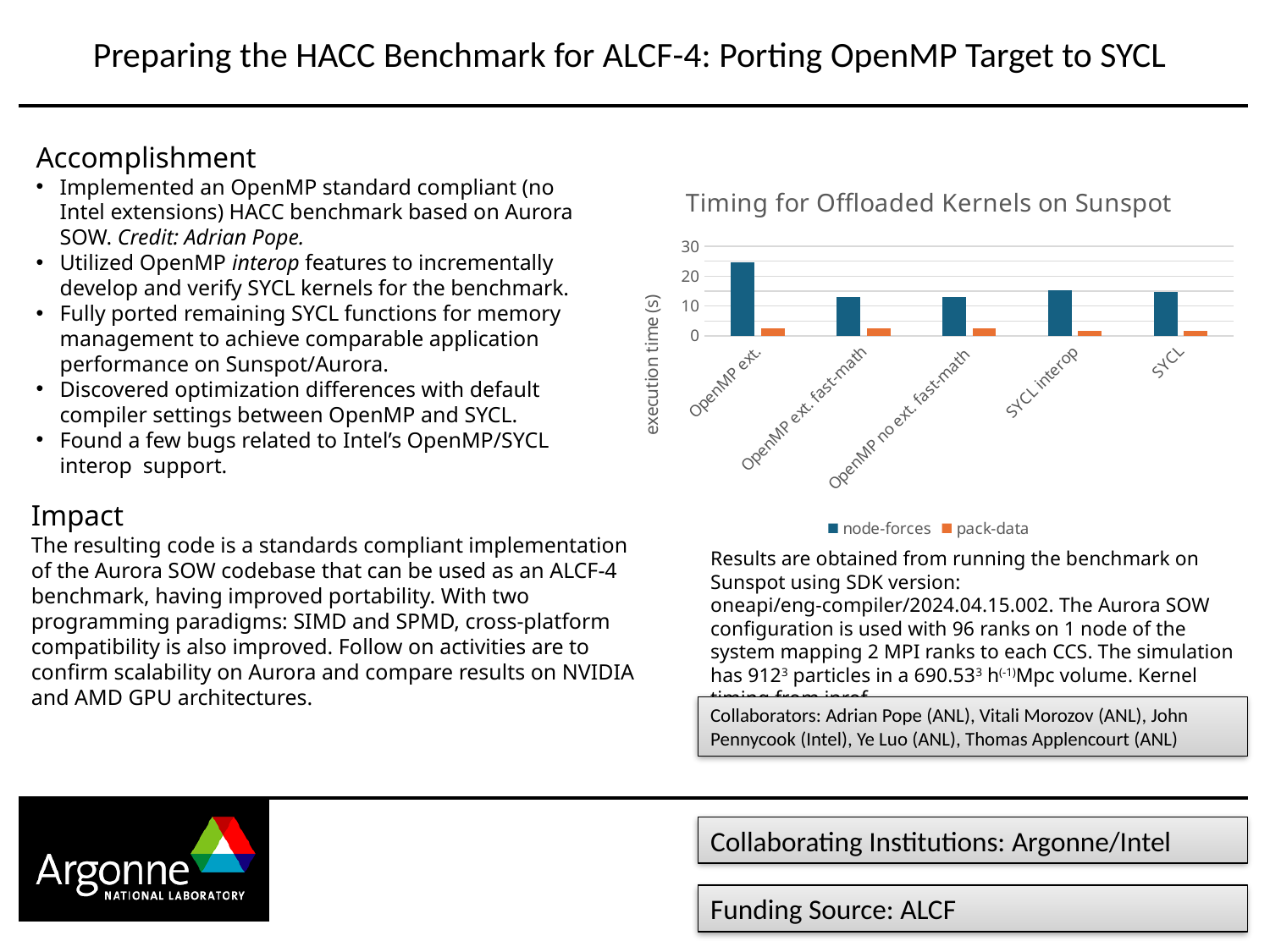
Is the node-forces value for SYCL greater or less than 10? greater What kind of chart is shown on the slide? bar chart For SYCL interop, which series has the larger value, node-forces or pack-data? node-forces What is the title of the chart? Timing for Offloaded Kernels on Sunspot Which category has the highest node-forces execution time? OpenMP ext. What is the label of the y axis of the chart? execution time (s) How many series does the chart legend list? 2 Which is larger: the node-forces value for OpenMP ext. or the node-forces value for SYCL? OpenMP ext. Is the node-forces value for SYCL interop greater or less than 20? less How many categories are shown on the x axis of the chart? 5 Is the node-forces value for OpenMP ext. greater or less than 20? greater